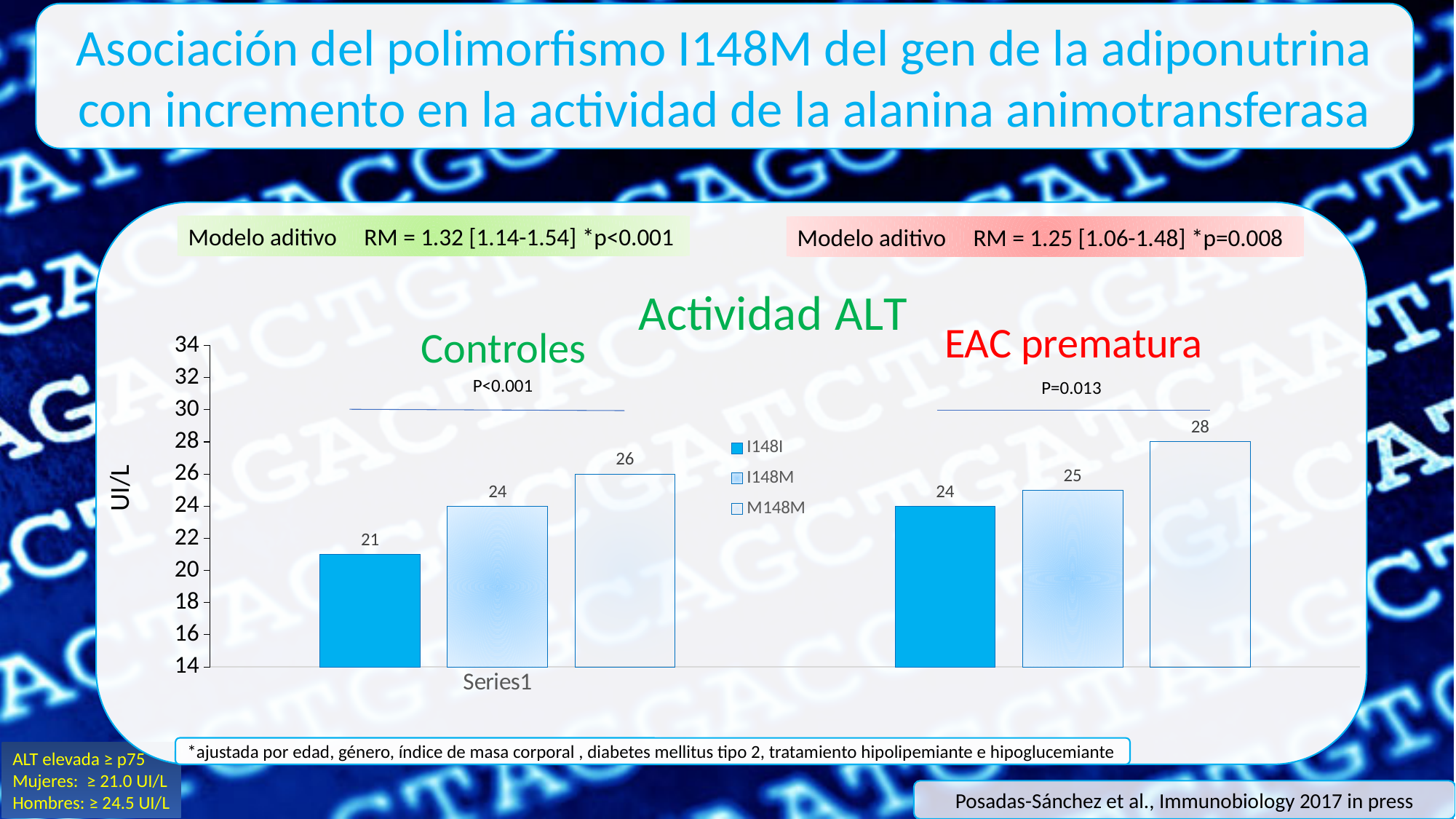
What is the ALT value for the I148M genotype in the Controles group? 24 What kind of chart is shown on the slide? bar chart What is the ALT value for the I148I genotype in the Controles group? 21 How many series does the legend of the Actividad ALT chart list? 3 What is the ALT value for the I148M genotype in the EAC prematura group? 25 Which genotype has the lowest ALT value in the Controles group? I148I Which genotype has the highest ALT value in the EAC prematura group? M148M What is the unit shown on the y axis of the chart? UI/L Which is larger: the I148I value in the EAC prematura group or the I148I value in the Controles group? EAC prematura What is the difference between the M148M and I148I ALT values in the Controles group? 5 Do the ALT values rise or fall from I148I to M148M within the Controles group? rise What is the ALT value for the M148M genotype in the EAC prematura group? 28